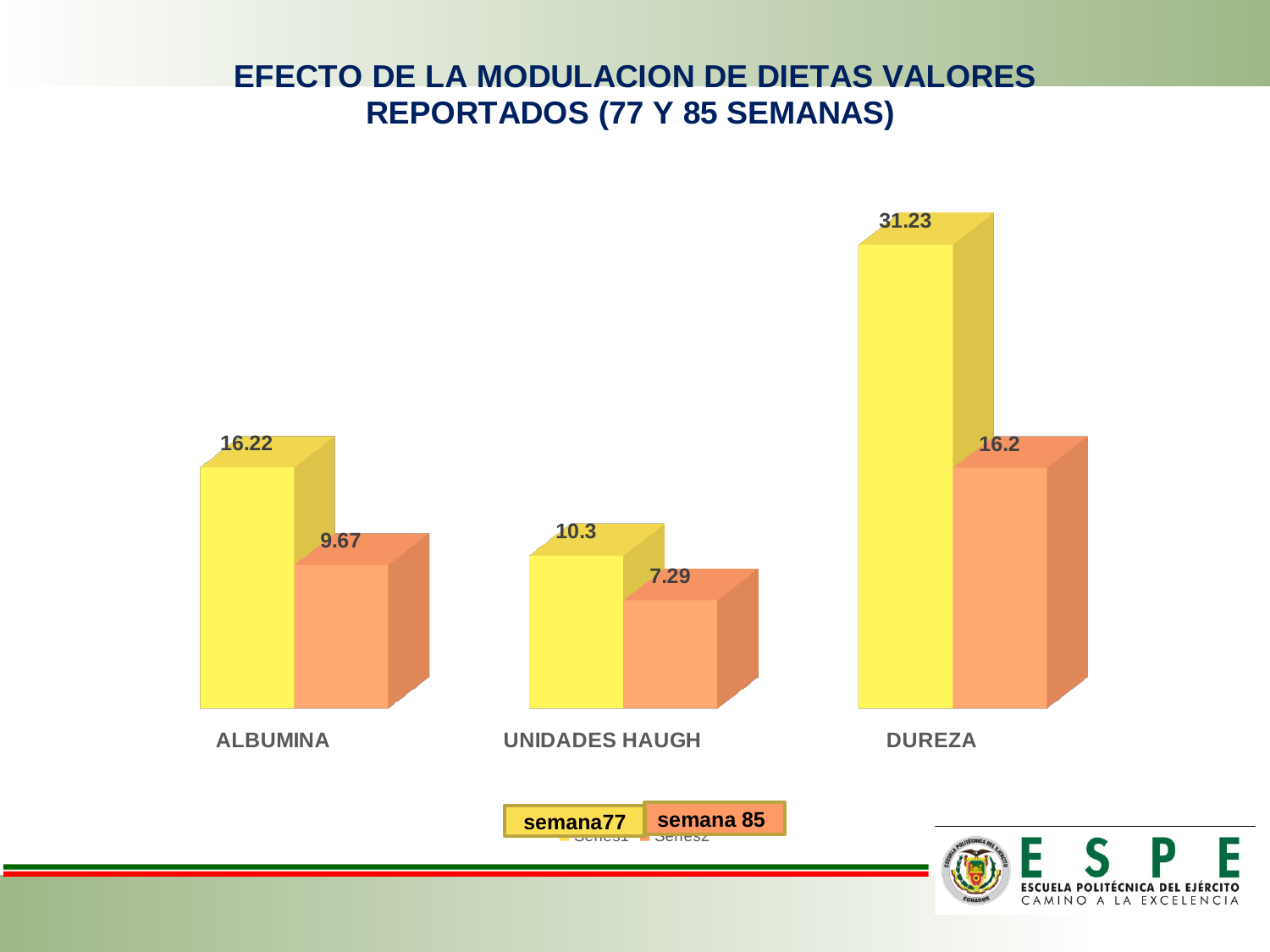
How many categories are shown on the x axis? 3 What is the difference between the semana77 and semana 85 values for ALBUMINA? 6.55 What kind of chart is shown on the slide? Bar chart What is the value for DUREZA in semana77? 31.23 What is the difference between the semana77 and semana 85 values for DUREZA? 15.03 Which is larger: the semana77 value for UNIDADES HAUGH or the semana 85 value for ALBUMINA? semana77 value for UNIDADES HAUGH What is the value for UNIDADES HAUGH in semana 85? 7.29 How many series does the legend list? 2 What is the value for DUREZA in semana 85? 16.2 Which category has the lowest value in semana 85? UNIDADES HAUGH Which category has the highest value in semana77? DUREZA What is the value for ALBUMINA in semana77? 16.22